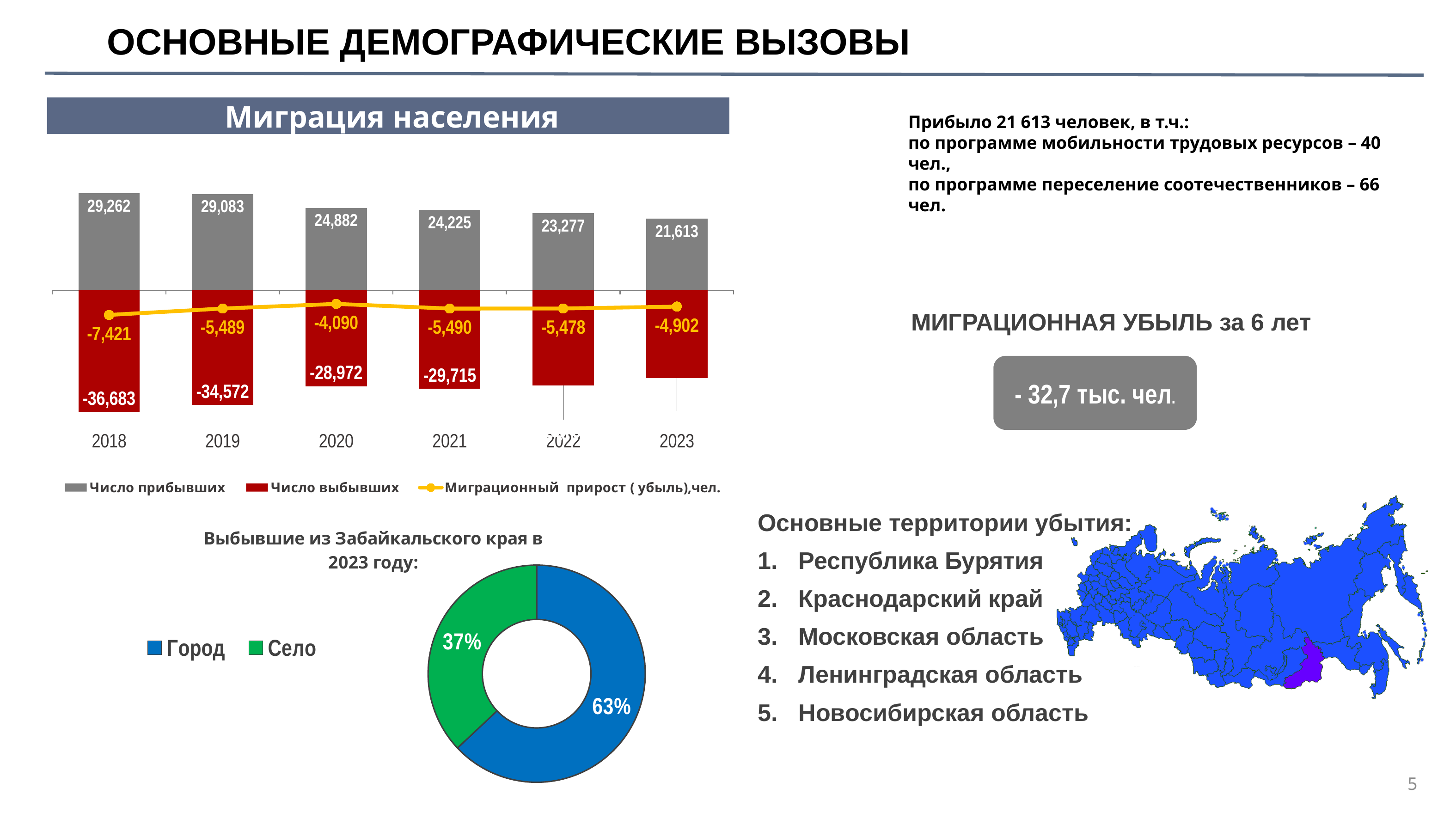
In the "Миграция населения" chart, what is the value of "Число выбывших" for 2020? -28,972 In the "Миграция населения" chart, is "Число прибывших" larger in 2020 or in 2021? 2020 In the "Миграция населения" chart, what is the value of "Число прибывших" for 2018? 29,262 What kind of chart is "Выбывшие из Забайкальского края в 2023 году"? donut (pie) chart In the "Миграция населения" chart, does "Число прибывших" rise or fall from 2018 to 2023? fall In the "Миграция населения" chart, what is the value of "Миграционный прирост (убыль)" for 2023? -4,902 In the "Миграция населения" chart, which year has the highest value of "Число прибывших"? 2018 In the "Миграция населения" chart, how many years are shown on the x axis? 6 In the donut chart "Выбывшие из Забайкальского края в 2023 году", what share does "Город" have? 63% In the "Миграция населения" chart, what is the difference between "Число прибывших" in 2018 and in 2023? 7,649 In the "Миграция населения" chart, which year has the lowest value of "Число прибывших"? 2023 In the "Миграция населения" chart, how many series does the legend list? 3